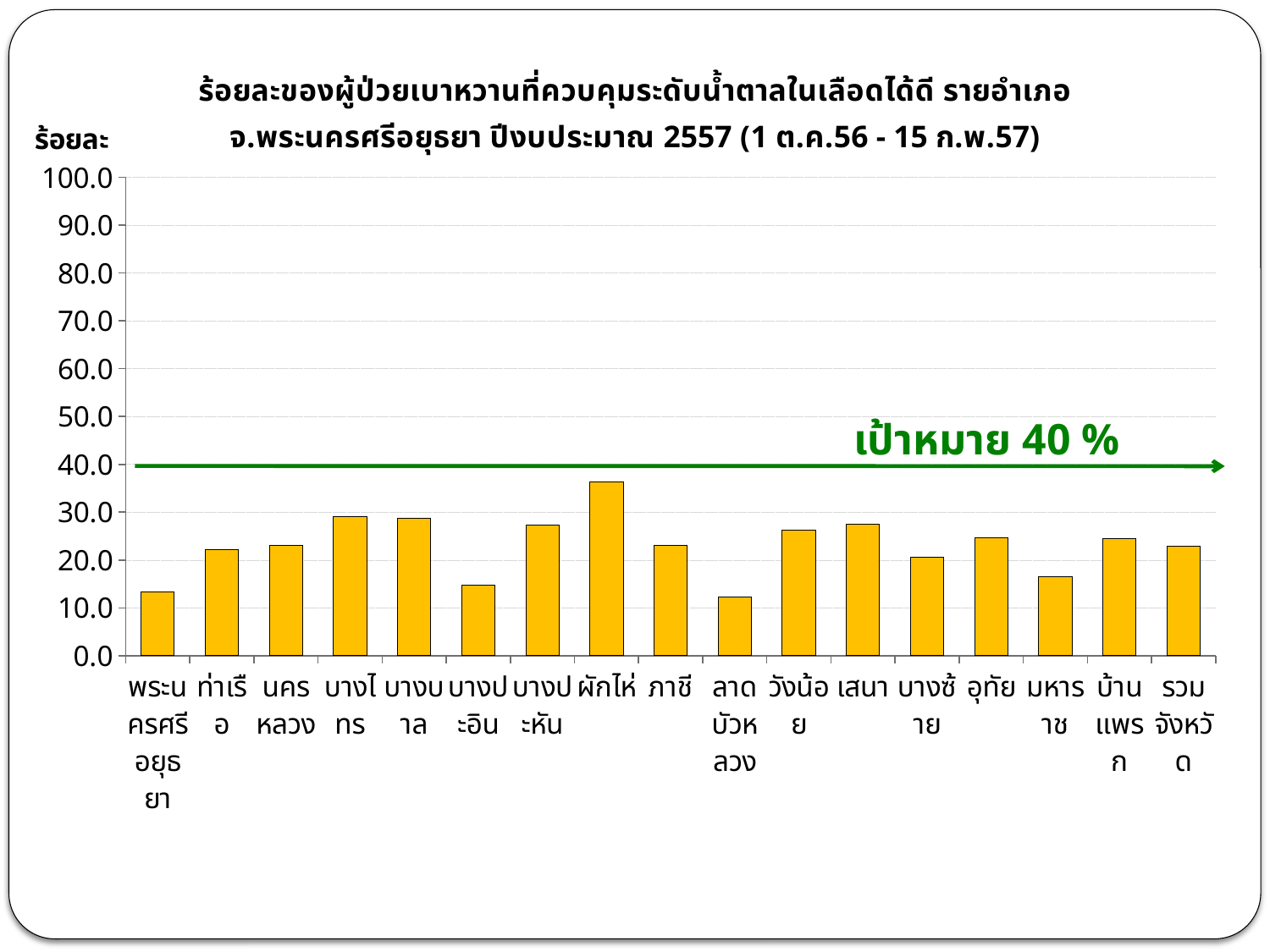
Is the value for ลาดบัวหลวง greater or less than 10? greater Which is larger, the value for ผักไห่ or the value for ภาชี? ผักไห่ What is the label on the vertical axis of the chart? ร้อยละ Is the value for รวมจังหวัด greater or less than 20? greater Is the value for ผักไห่ greater or less than 30? greater How many categories (bars) are shown on the x axis? 17 What target percentage is marked by the green arrow line on the chart? 40 % Which is larger, the value for บางไทร or the value for บางปะอิน? บางไทร What kind of chart is shown on the slide? Bar chart Which district has the highest percentage of diabetic patients with well-controlled blood sugar? ผักไห่